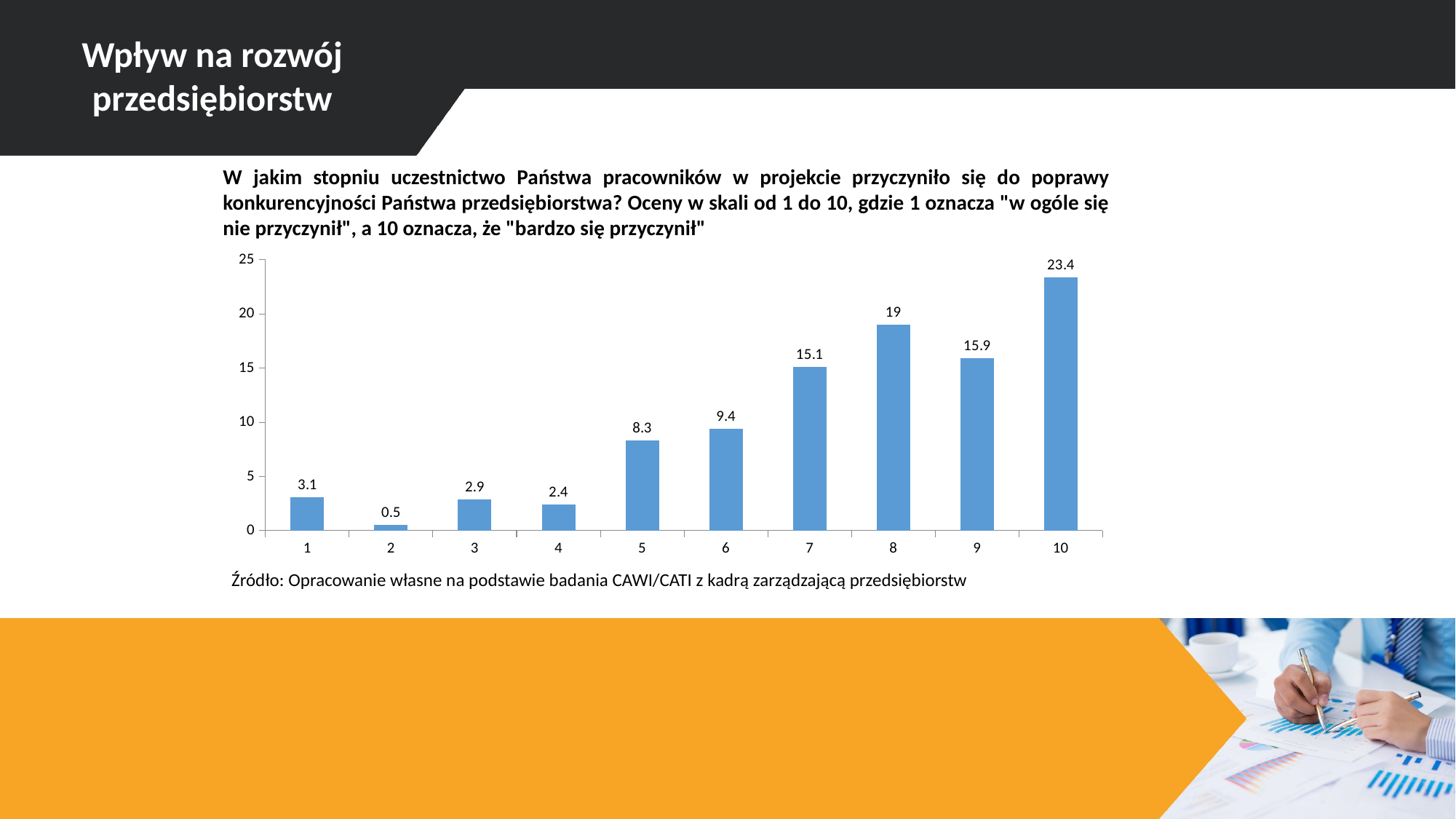
What is the difference between the values for category 10 and category 8? 4.4 What is the value for category 7? 15.1 Is the value for category 6 greater or less than 10? less What is the value for category 10? 23.4 Which category has the lowest value? 2 What is the difference between the values for category 1 and category 3? 0.2 Which category has the highest value? 10 What is the value for category 2? 0.5 Which is larger, the value for category 8 or the value for category 9? 8 What colour are the bars in the chart? blue What kind of chart is shown on the slide? bar chart How many categories are shown on the x axis? 10